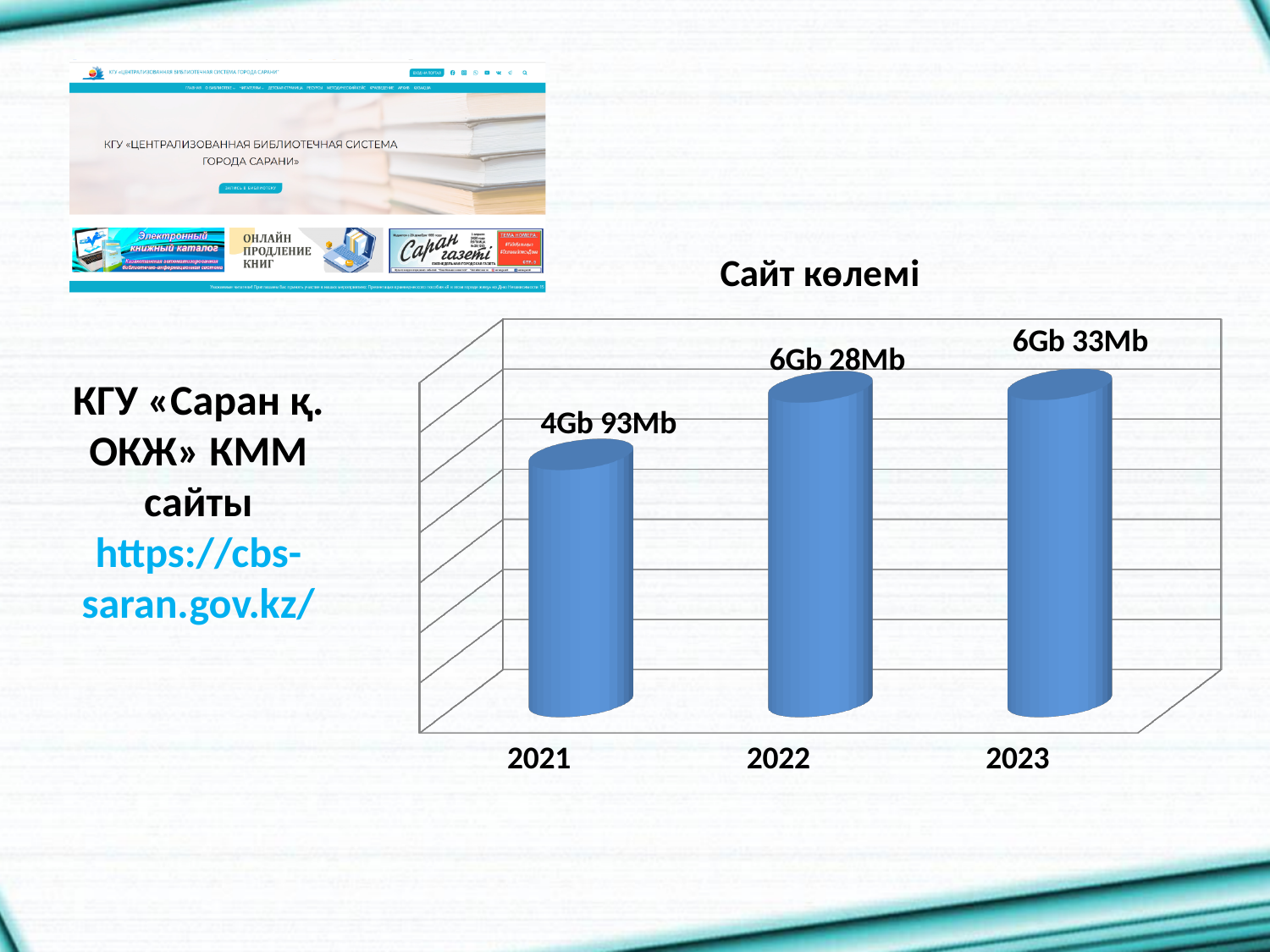
Which year has the highest value? 2023 What is the title of the chart? Сайт көлемі Do the values rise or fall from 2021 to 2023? Rise What colour are the bars in the chart? Blue Which is larger, the value for 2021 or the value for 2022? 2022 What is the value shown for 2023? 6Gb 33Mb How many years are shown on the chart? 3 Which year has the lowest value? 2021 By how much does the value for 2023 exceed the value for 2022? 5Mb What kind of chart is shown on the slide? Bar chart What is the value shown for 2022? 6Gb 28Mb What is the value shown for 2021? 4Gb 93Mb